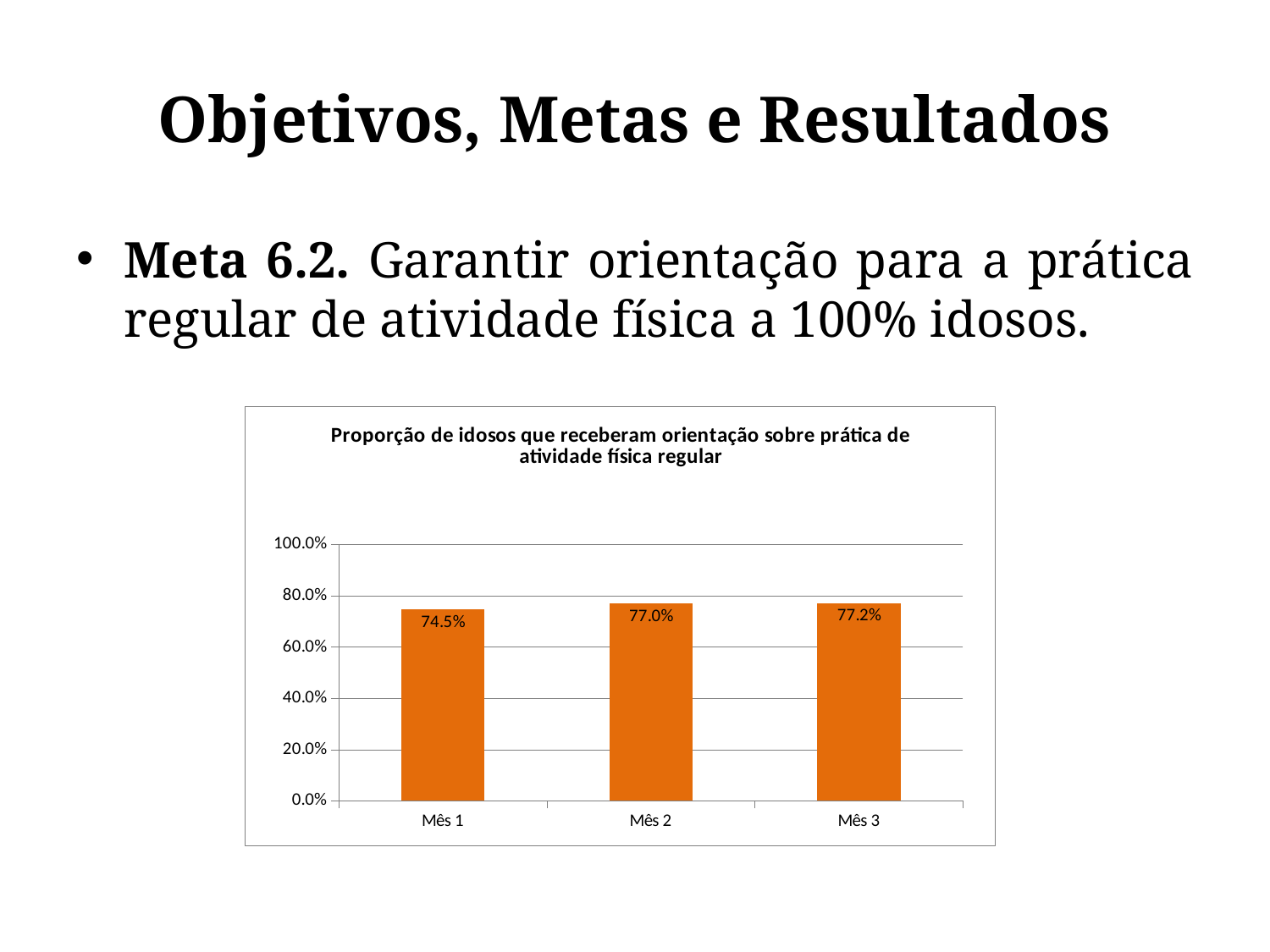
Do the values rise or fall from Mês 1 to Mês 3? rise What is the value for Mês 1? 74.5% What is the difference between the values for Mês 2 and Mês 1? 2.5% What kind of chart is shown on the slide? bar chart What is the value for Mês 2? 77.0% Is the value for Mês 1 greater or less than 80.0%? less How many months are shown on the x axis? 3 Which is larger, the value for Mês 1 or the value for Mês 2? Mês 2 What is the value for Mês 3? 77.2% Which month has the highest proportion? Mês 3 What is the difference between the values for Mês 3 and Mês 1? 2.7% Which month has the lowest proportion? Mês 1